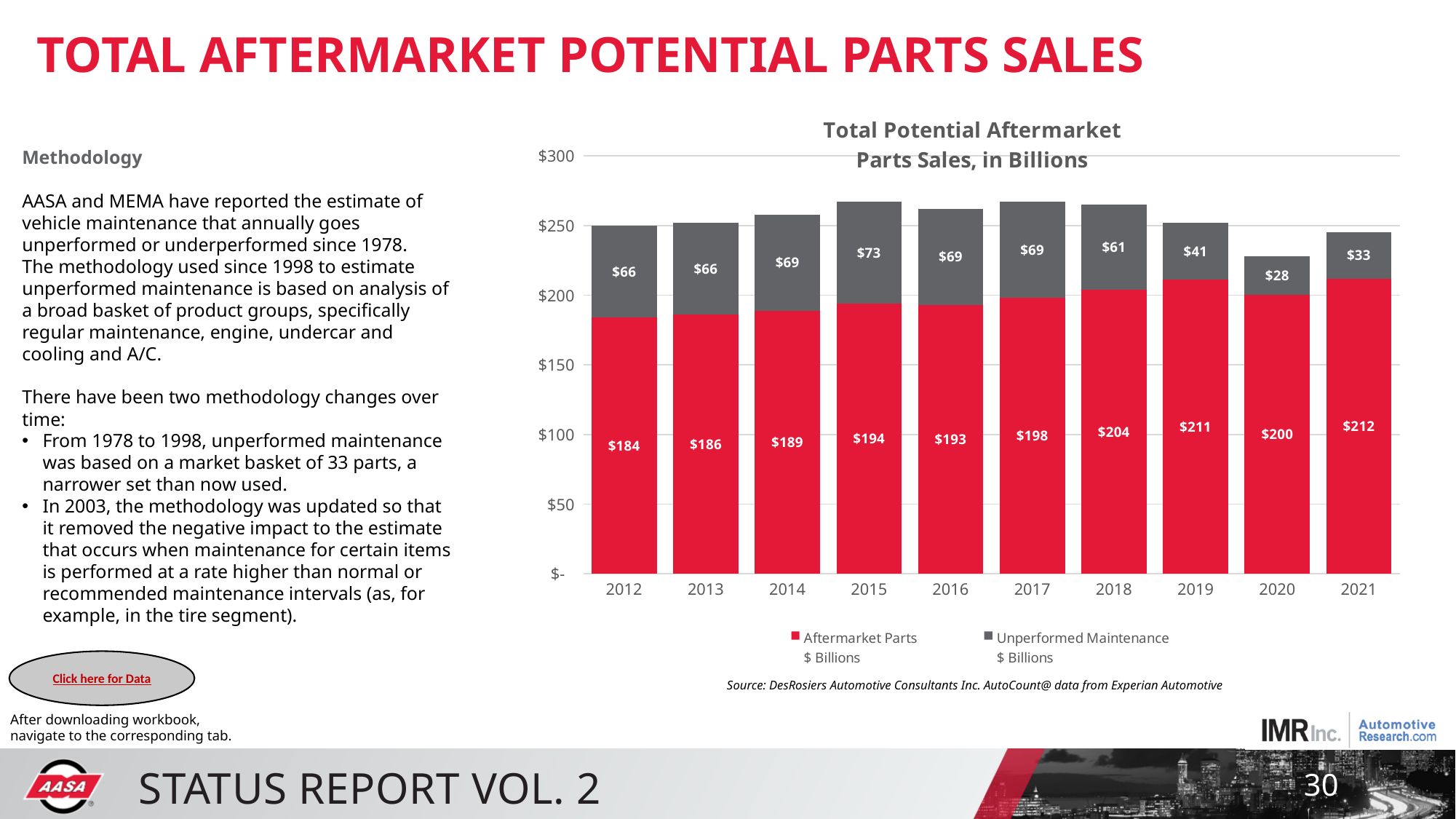
Does the Unperformed Maintenance value rise or fall from 2017 to 2020? Fall Which year has the highest Aftermarket Parts value? 2021 How many years are shown on the x axis? 10 What is the total of the stacked bar for 2020? $228 What is the difference between the Aftermarket Parts values for 2021 and 2012? $28 What kind of chart is shown? Stacked bar chart Which is larger, the Unperformed Maintenance value for 2015 or for 2019? 2015 What is the Aftermarket Parts value for 2015? $194 How many series does the legend list? 2 What is the total of the stacked bar for 2015? $267 What is the Unperformed Maintenance value for 2020? $28 Which year has the lowest Unperformed Maintenance value? 2020